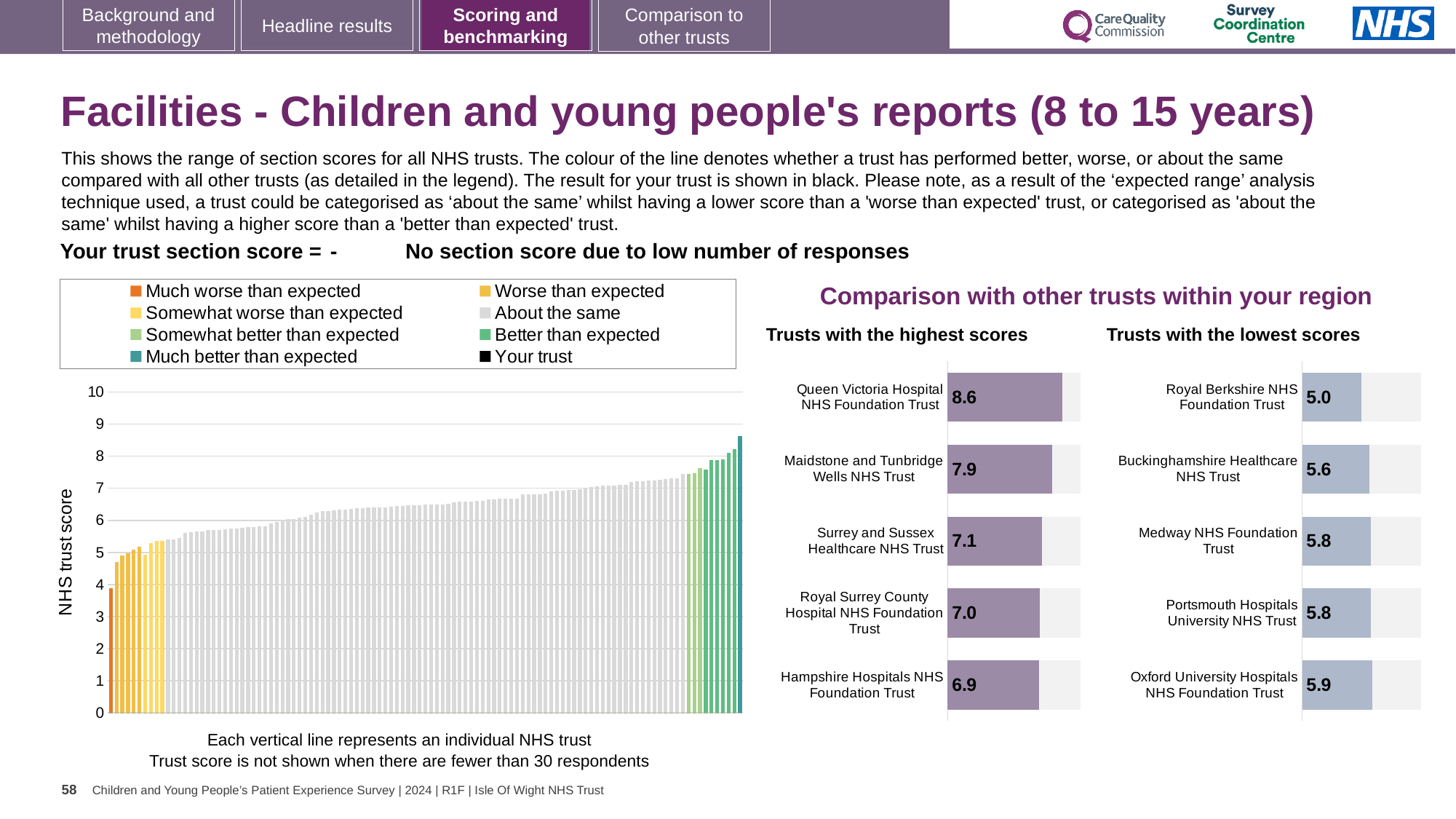
In the 'Trusts with the lowest scores' chart, what is the score for Oxford University Hospitals NHS Foundation Trust? 5.9 In the 'Trusts with the highest scores' chart, what is the difference between the scores of Queen Victoria Hospital NHS Foundation Trust and Maidstone and Tunbridge Wells NHS Trust? 0.7 In the 'Trusts with the highest scores' chart, which has the higher score: Surrey and Sussex Healthcare NHS Trust or Royal Surrey County Hospital NHS Foundation Trust? Surrey and Sussex Healthcare NHS Trust In the 'Trusts with the highest scores' chart, which trust has the highest score? Queen Victoria Hospital NHS Foundation Trust How many entries does the legend of the main NHS trust score chart list? 8 In the 'Trusts with the highest scores' chart, what is the score for Queen Victoria Hospital NHS Foundation Trust? 8.6 In the 'Trusts with the lowest scores' chart, which trust has the lowest score? Royal Berkshire NHS Foundation Trust In the main NHS trust score chart on the left, is the value of the tallest bar greater or less than 8? greater How many trusts are shown in the 'Trusts with the highest scores' chart? 5 What kind of chart is the main chart on the left showing NHS trust scores? Bar chart In the 'Trusts with the lowest scores' chart, what is the score for Royal Berkshire NHS Foundation Trust? 5.0 In the 'Trusts with the lowest scores' chart, what is the difference between the scores of Oxford University Hospitals NHS Foundation Trust and Royal Berkshire NHS Foundation Trust? 0.9